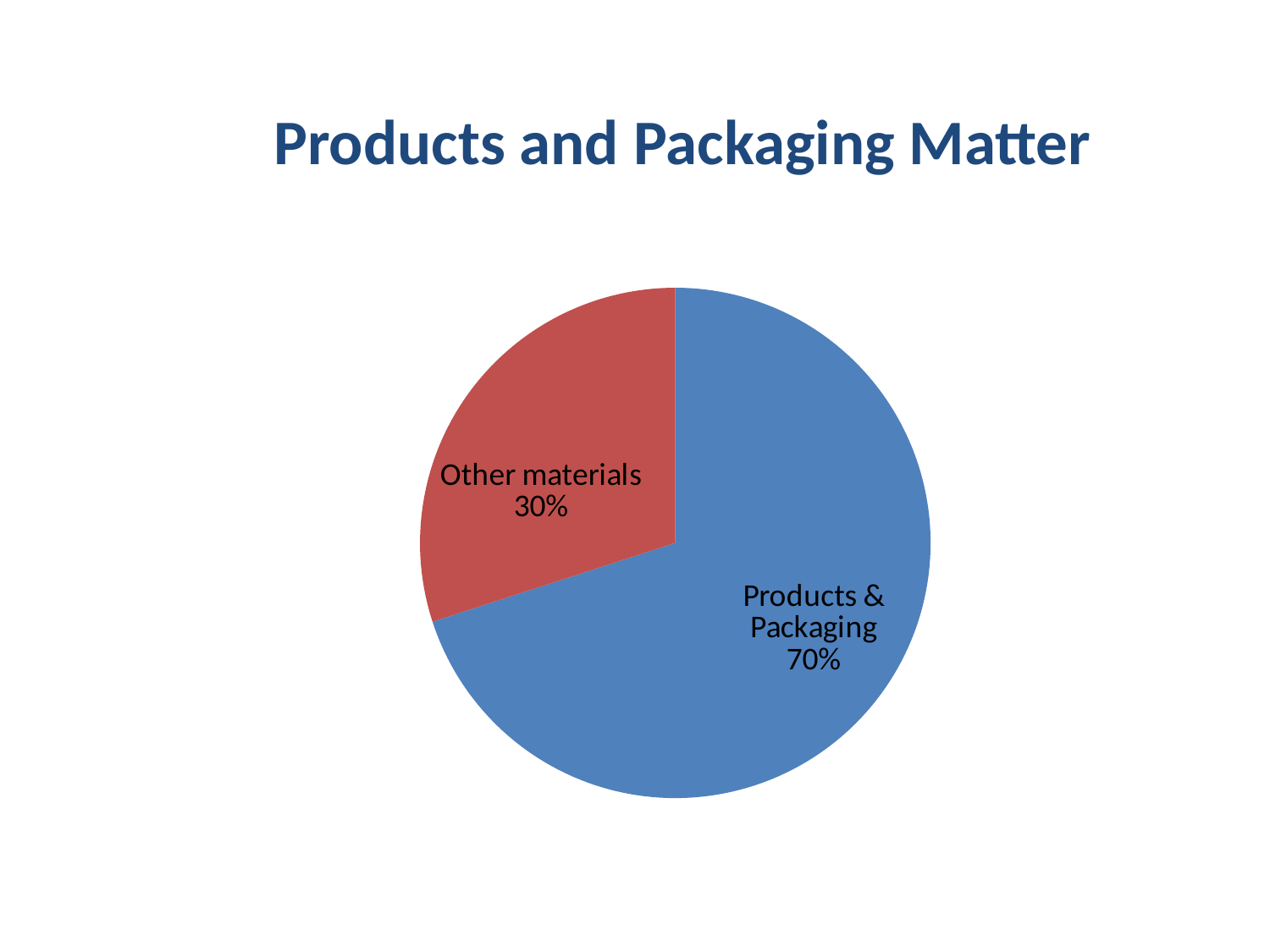
Which slice of the pie is the smallest? Other materials What colour is the Other materials slice? red What share of the pie is Other materials? 30% What is the title of the slide containing the pie chart? Products and Packaging Matter Which is larger, the Products & Packaging slice or the Other materials slice? Products & Packaging What is the difference in percentage points between the Products & Packaging slice and the Other materials slice? 40 percentage points What kind of chart is shown on the slide? pie chart How many slices does the pie chart have? 2 Which slice of the pie is the largest? Products & Packaging What share of the pie is Products & Packaging? 70%